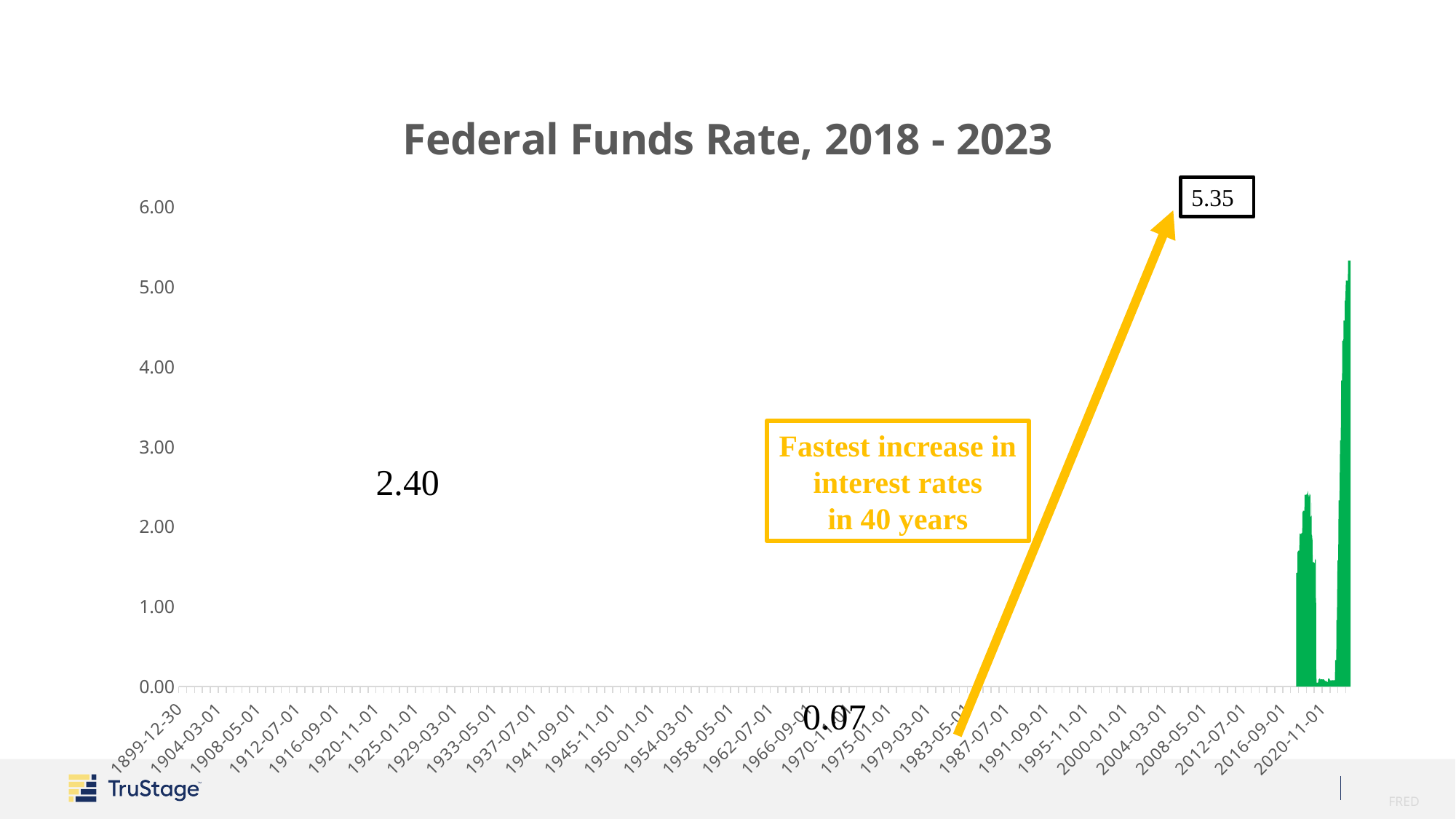
Does the Federal Funds Rate rise or fall at the right-hand end of the chart? rise Is the earlier peak of the Federal Funds Rate greater or less than 3.00? less What value is labelled for the earlier, smaller peak in the Federal Funds Rate? 2.40 What is the lowest value labelled on the chart? 0.07 What does the yellow callout box on the chart say? Fastest increase in interest rates in 40 years What is the difference between the labelled peak of 5.35 and the labelled low of 0.07? 5.28 What is the title of the chart? Federal Funds Rate, 2018 - 2023 Which labelled peak is larger, 5.35 or 2.40? 5.35 What is the highest value labelled on the chart? 5.35 What is the highest tick value shown on the y-axis? 6.00 Is the final peak of the Federal Funds Rate greater or less than 5.00? greater What is the difference between the two labelled peaks, 5.35 and 2.40? 2.95